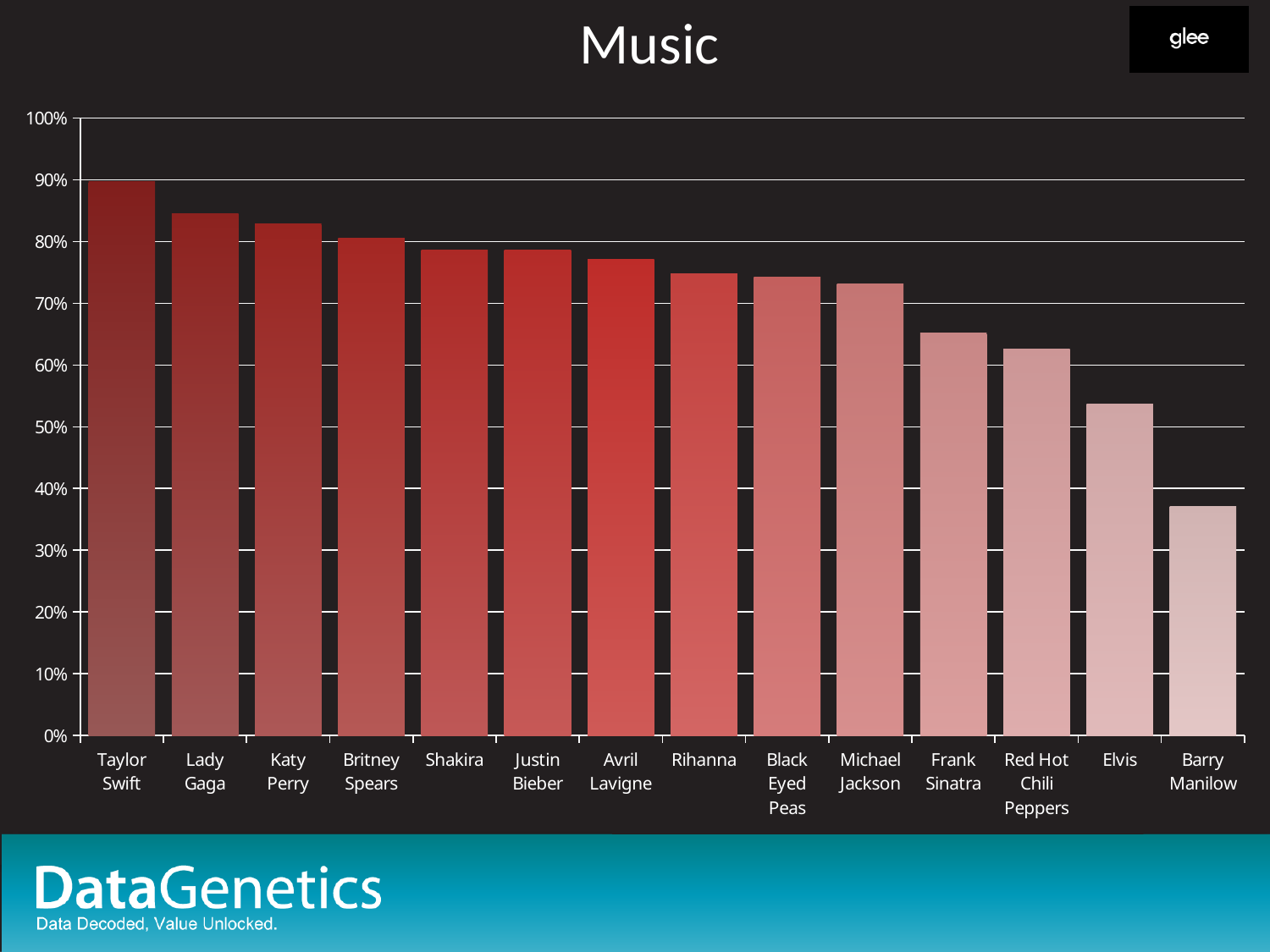
Is the value for Barry Manilow greater or less than 40%? less Is the value for Elvis greater or less than 50%? greater Which artist has the highest value in the chart? Taylor Swift What is the title of the chart? Music Is the value for Frank Sinatra greater or less than 70%? less Do the values rise or fall moving from left to right along the x axis? fall Which artist has the lowest value in the chart? Barry Manilow How many artists are shown on the x axis of the chart? 14 Which has a larger value, Lady Gaga or Rihanna? Lady Gaga What type of chart is shown on the slide? bar chart